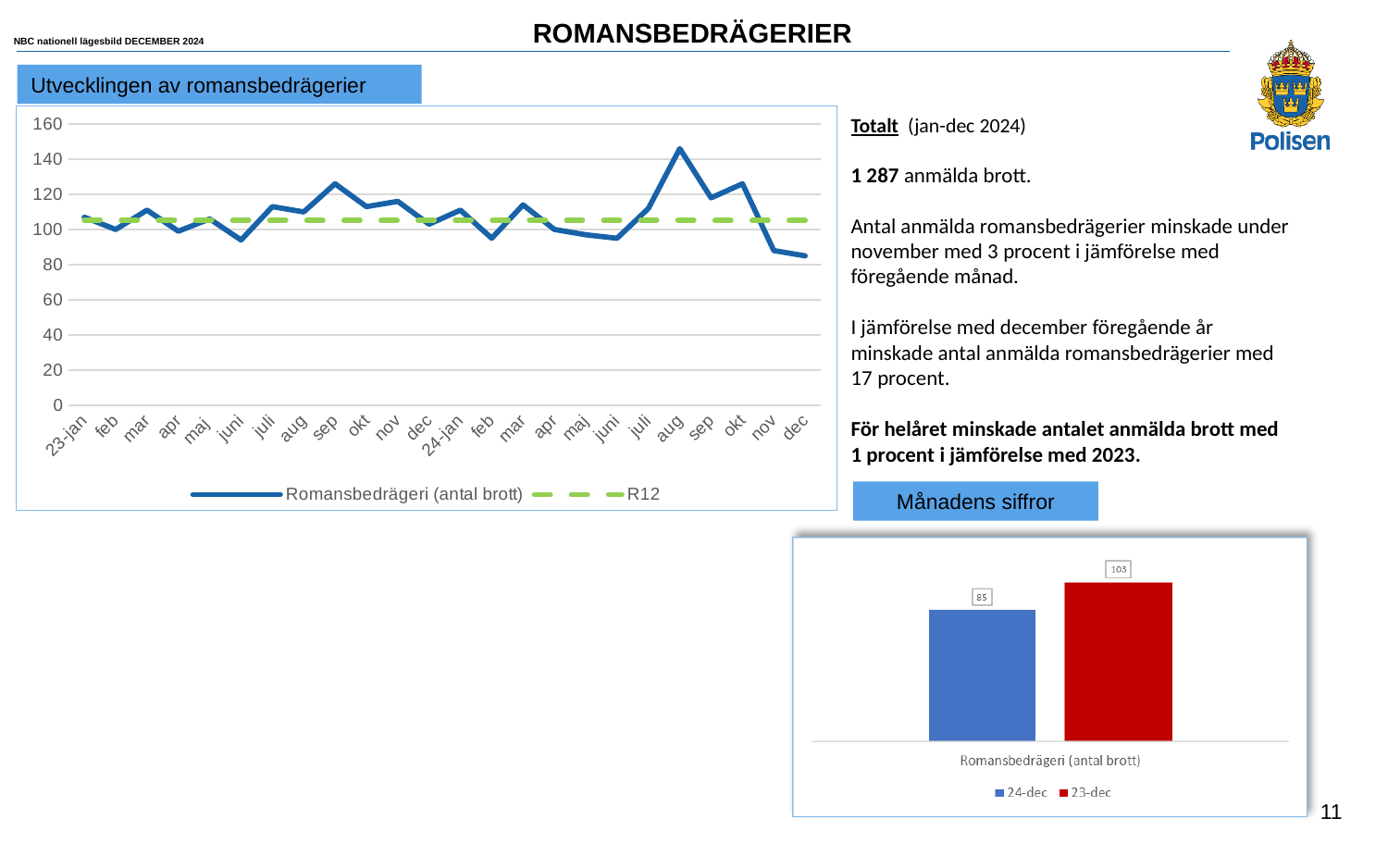
In the 'Månadens siffror' chart, what is the value for 23-dec? 103 In the 'Utvecklingen av romansbedrägerier' chart, is the value for Romansbedrägeri (antal brott) in aug 2024 greater or less than 140? greater In the 'Utvecklingen av romansbedrägerier' chart, what is the name of the dashed series in the legend? R12 In the 'Månadens siffror' chart, what is the difference between the 23-dec and 24-dec values? 18 How many series does the legend of the 'Utvecklingen av romansbedrägerier' chart list? 2 In the 'Utvecklingen av romansbedrägerier' chart, is the value for Romansbedrägeri (antal brott) in dec 2024 greater or less than 100? less In the 'Utvecklingen av romansbedrägerier' chart, in which month does the Romansbedrägeri (antal brott) line reach its highest point? aug 2024 In the 'Månadens siffror' chart, which bar is higher, 24-dec or 23-dec? 23-dec What kind of chart is the 'Månadens siffror' chart? Bar chart How many series does the legend of the 'Månadens siffror' chart list? 2 In the 'Månadens siffror' chart, what is the value for 24-dec? 85 What kind of chart is the 'Utvecklingen av romansbedrägerier' chart? Line chart